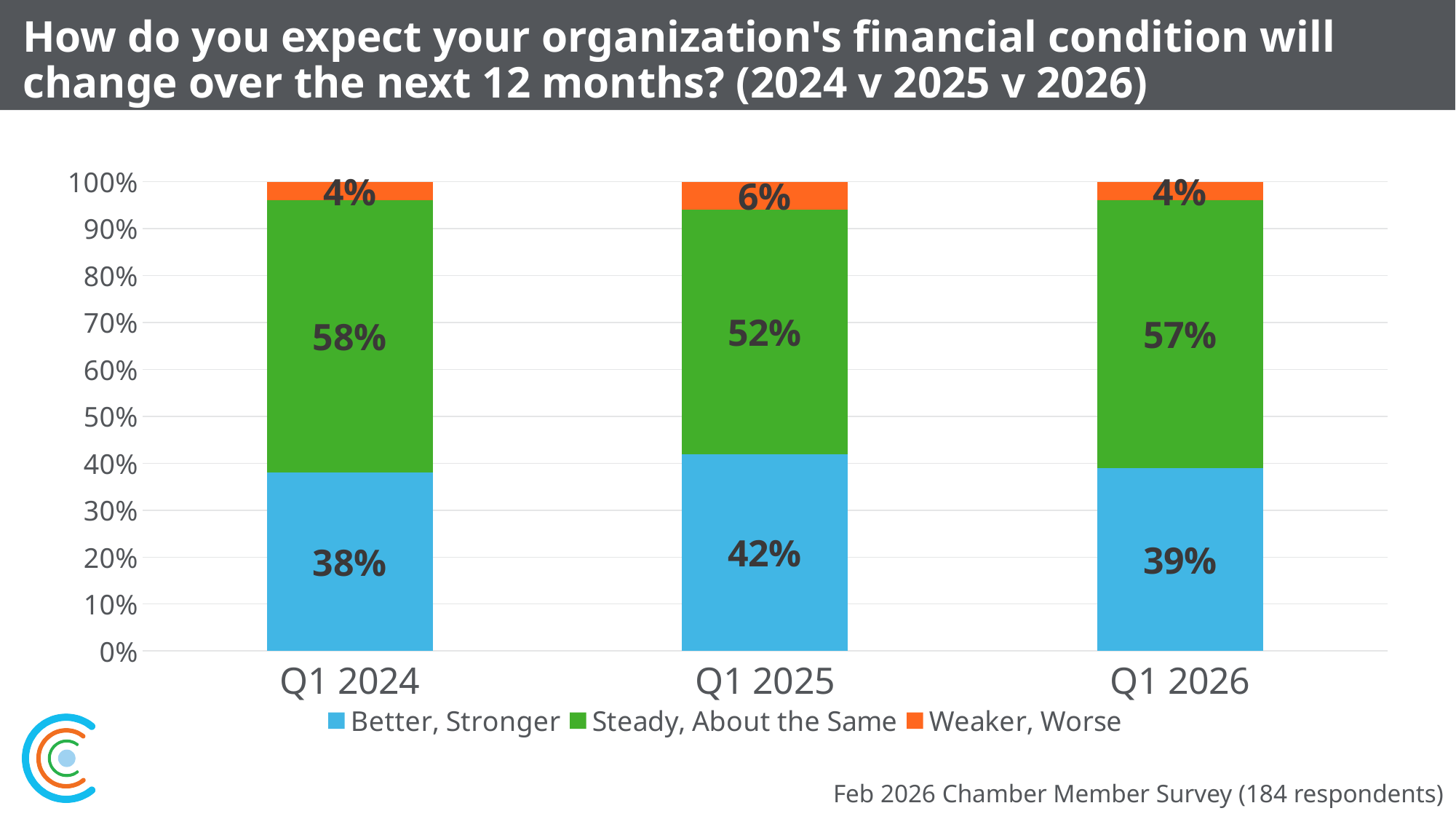
Is the Better, Stronger value for Q1 2026 greater or less than 50%? less In which quarter is the Better, Stronger share highest? Q1 2025 What percentage of respondents in Q1 2025 expected their organization's financial condition to be Better, Stronger? 42% What kind of chart is shown on the slide? Stacked bar chart What is the value for Steady, About the Same in Q1 2024? 58% How many series does the legend list? 3 In which quarter is the Steady, About the Same share lowest? Q1 2025 What is the difference between the Steady, About the Same values for Q1 2024 and Q1 2025? 6 percentage points What is the value for Weaker, Worse in Q1 2026? 4% Which colour represents Weaker, Worse in the chart? Orange Which is larger: the Weaker, Worse value for Q1 2025 or for Q1 2026? Q1 2025 How many quarters are shown on the x axis? 3